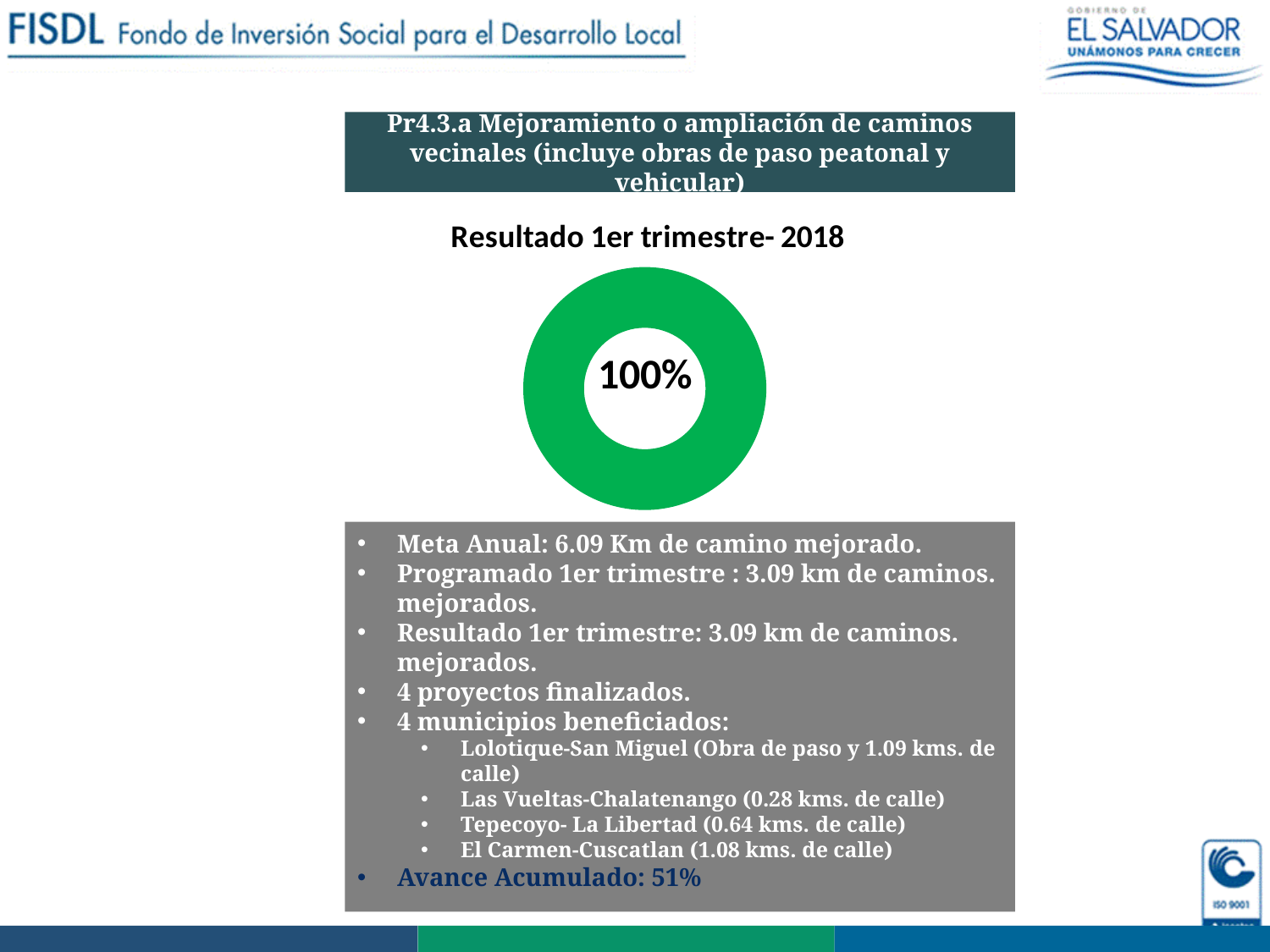
What is the title shown directly above the doughnut chart? Resultado 1er trimestre- 2018 How many slices does the doughnut chart contain? 1 What percentage is printed in the centre of the doughnut chart? 100% What share of the doughnut chart does the green slice occupy? 100% What kind of chart is shown under the heading "Resultado 1er trimestre- 2018"? Doughnut chart What colour is the ring of the doughnut chart? Green